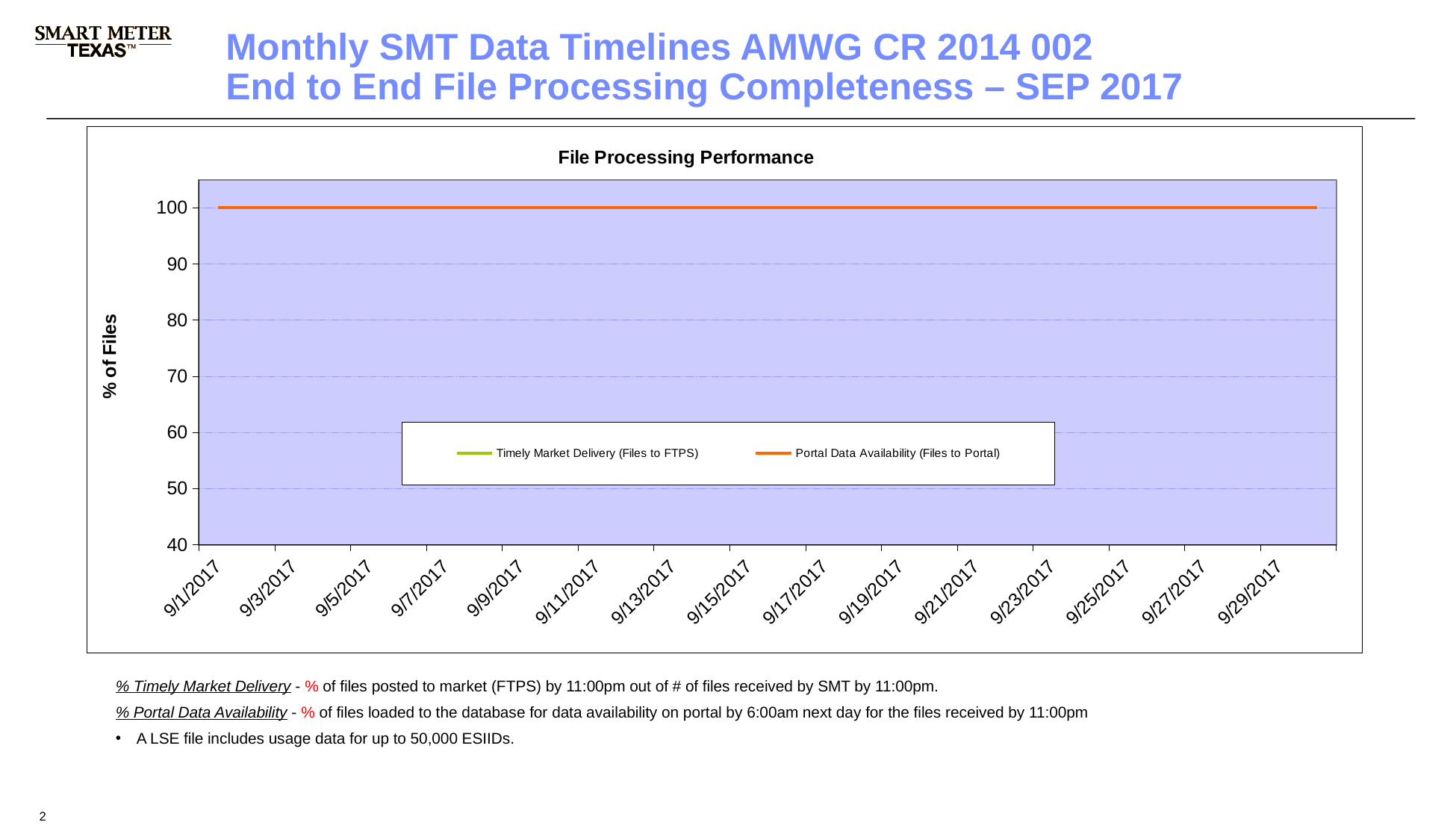
What is the lowest value shown on the y axis? 40 What is the highest value shown on the y axis? 100 What kind of chart is shown on the slide? line chart What colour is the Portal Data Availability (Files to Portal) line? orange Is the value for Portal Data Availability (Files to Portal) on 9/21/2017 greater or less than 90? greater Do the plotted values rise, fall, or stay flat across the dates on the x axis? stay flat What is the value of Timely Market Delivery (Files to FTPS) on 9/1/2017? 100 How many date labels are shown on the x axis? 15 What is the difference between the Portal Data Availability value on 9/29/2017 and the Timely Market Delivery value on 9/29/2017? 0 What is the value of Portal Data Availability (Files to Portal) on 9/15/2017? 100 What is the title of the chart? File Processing Performance How many series does the legend of the File Processing Performance chart list? 2